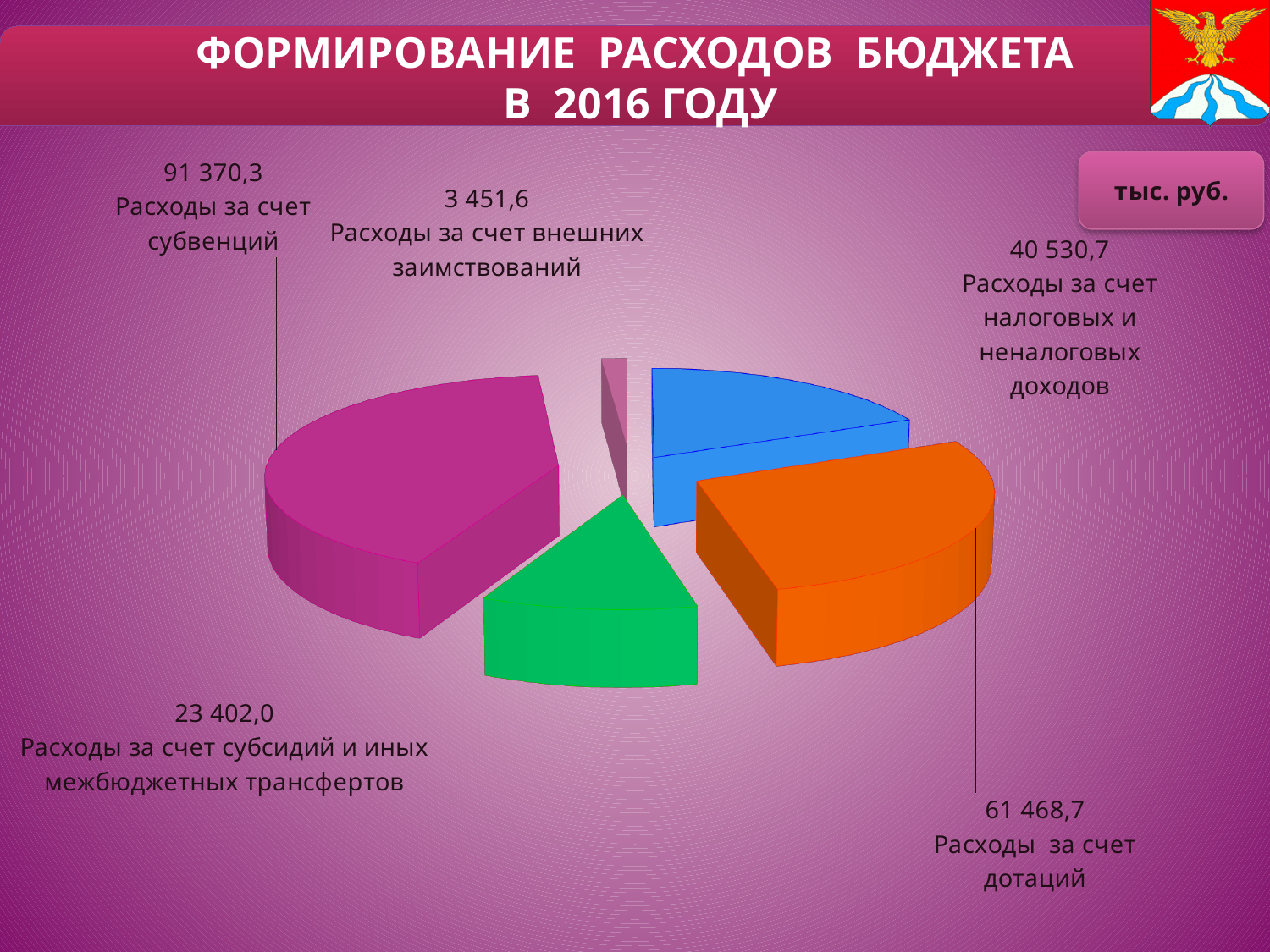
Which is larger: Расходы за счет дотаций or Расходы за счет субсидий и иных межбюджетных трансфертов? Расходы за счет дотаций How many slices does the pie chart have? 5 What kind of chart is shown on the slide? Pie chart What is the value for Расходы за счет налоговых и неналоговых доходов? 40 530,7 Which category has the smallest value? Расходы за счет внешних заимствований What is the value for Расходы за счет дотаций? 61 468,7 What is the value for Расходы за счет субвенций? 91 370,3 In what units are the values on the chart given? тыс. руб. What is the difference between Расходы за счет субвенций and Расходы за счет дотаций? 29 901,6 What is the total of all five categories in the pie chart? 220 223,3 Which category has the largest value? Расходы за счет субвенций What is the value for Расходы за счет внешних заимствований? 3 451,6